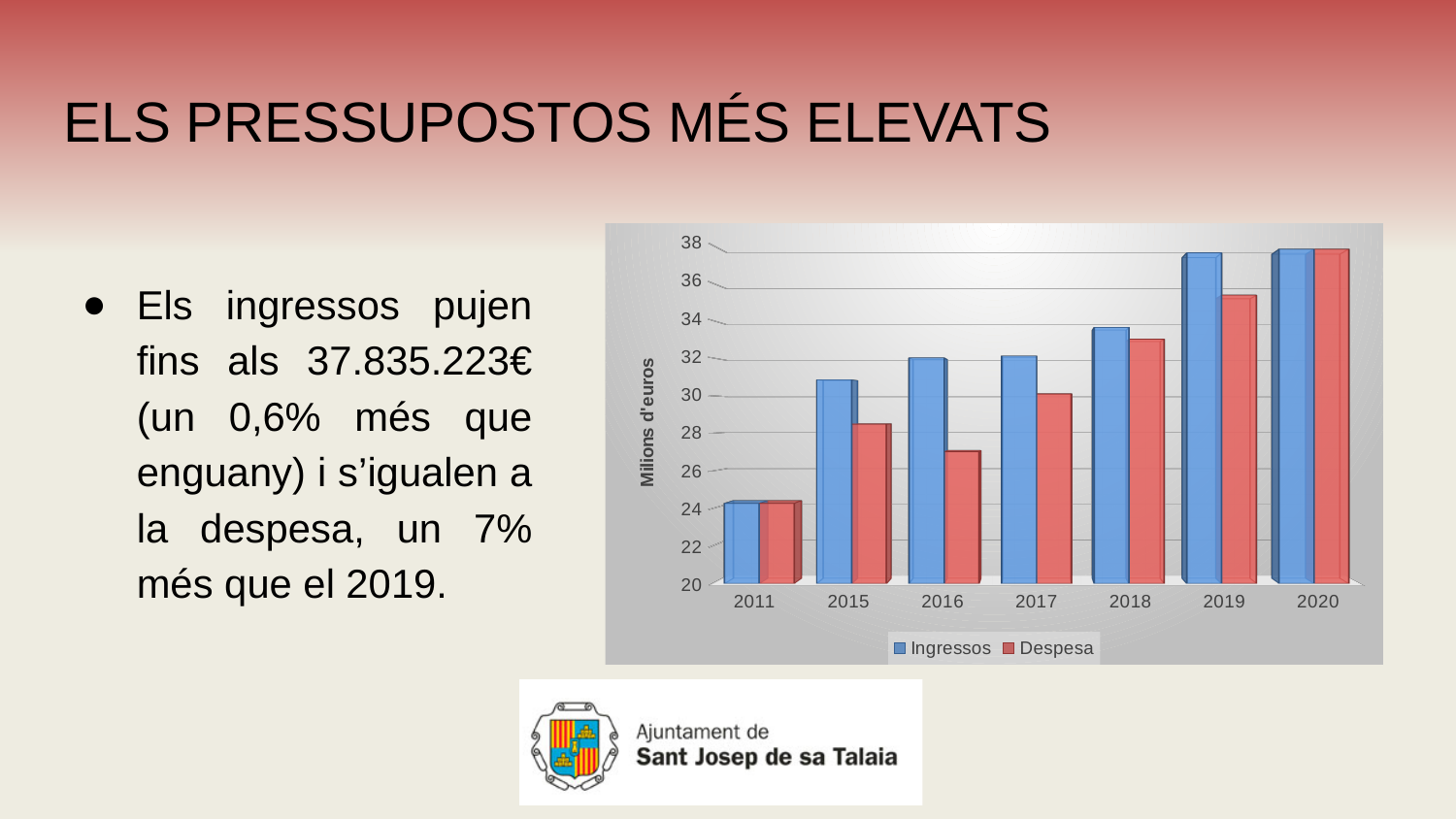
Is the Ingressos value for 2019 greater or less than 36? greater Which year has the lowest Despesa value? 2011 Which year has the highest Despesa value? 2020 How many years are shown on the x axis of the chart? 7 Is the Despesa value for 2016 greater or less than 28? less What kind of chart is shown on the slide? bar chart Do the Ingressos values generally rise or fall from 2011 to 2020? rise Is the Ingressos value for 2015 greater or less than 30? greater In 2016, which is larger: Ingressos or Despesa? Ingressos How many series does the chart's legend list? 2 Which year has the lowest Ingressos value? 2011 Which is larger: the Despesa value for 2017 or the Despesa value for 2015? 2017